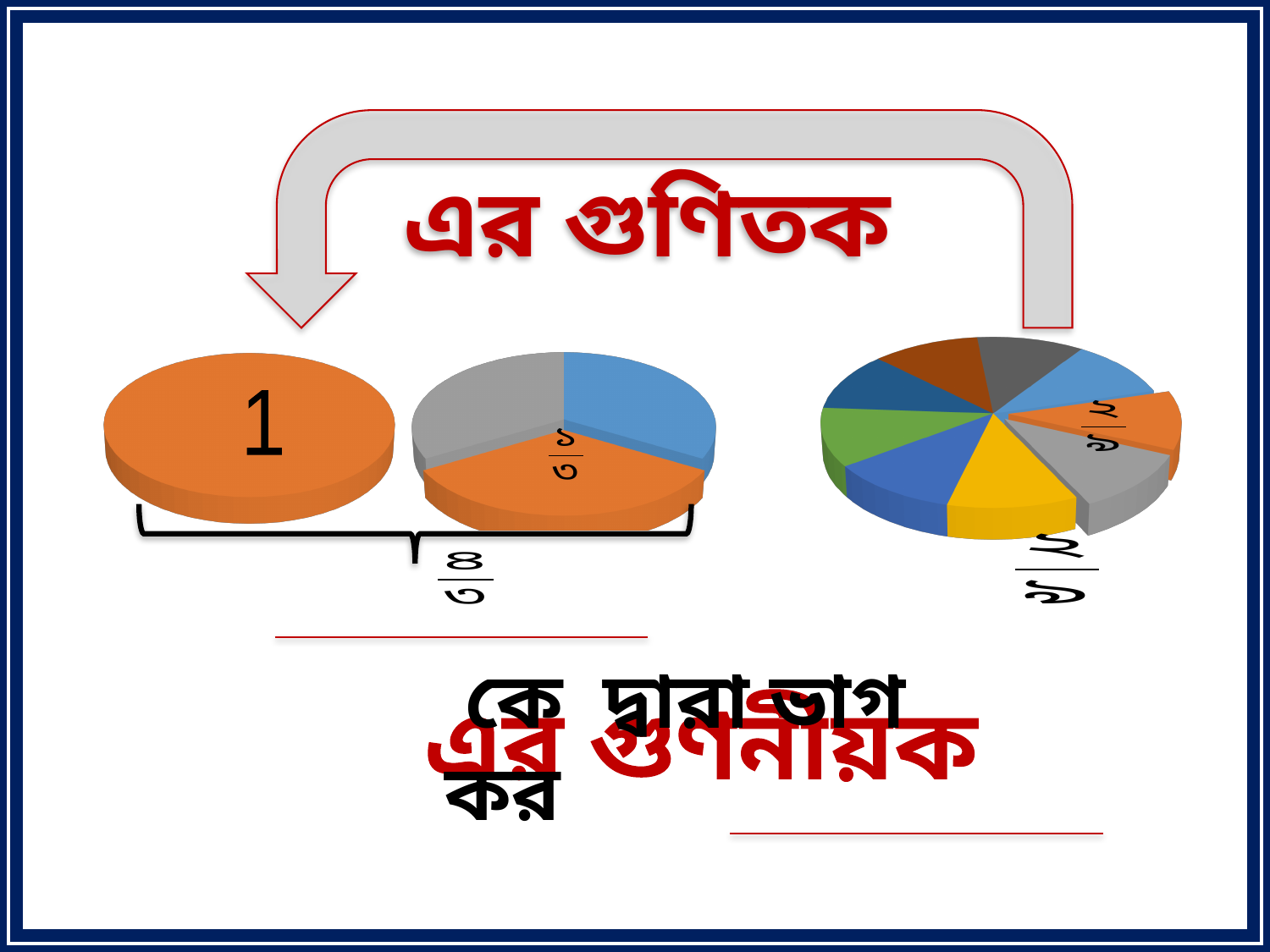
How many slices does the rightmost pie chart have? 9 What kind of chart is the rightmost chart on the slide? pie chart What label is printed on the exploded orange slice of the rightmost pie chart? ১/৯ What kind of chart is the middle chart on the slide? pie chart What number is printed on the leftmost orange circle chart? 1 What three colours are the slices of the middle pie chart? blue, orange and gray What label is printed on the middle pie chart? ১/৩ In the rightmost pie chart, which two slices are pulled out (exploded) from the pie? the orange and gray slices How many slices does the middle pie chart have? 3